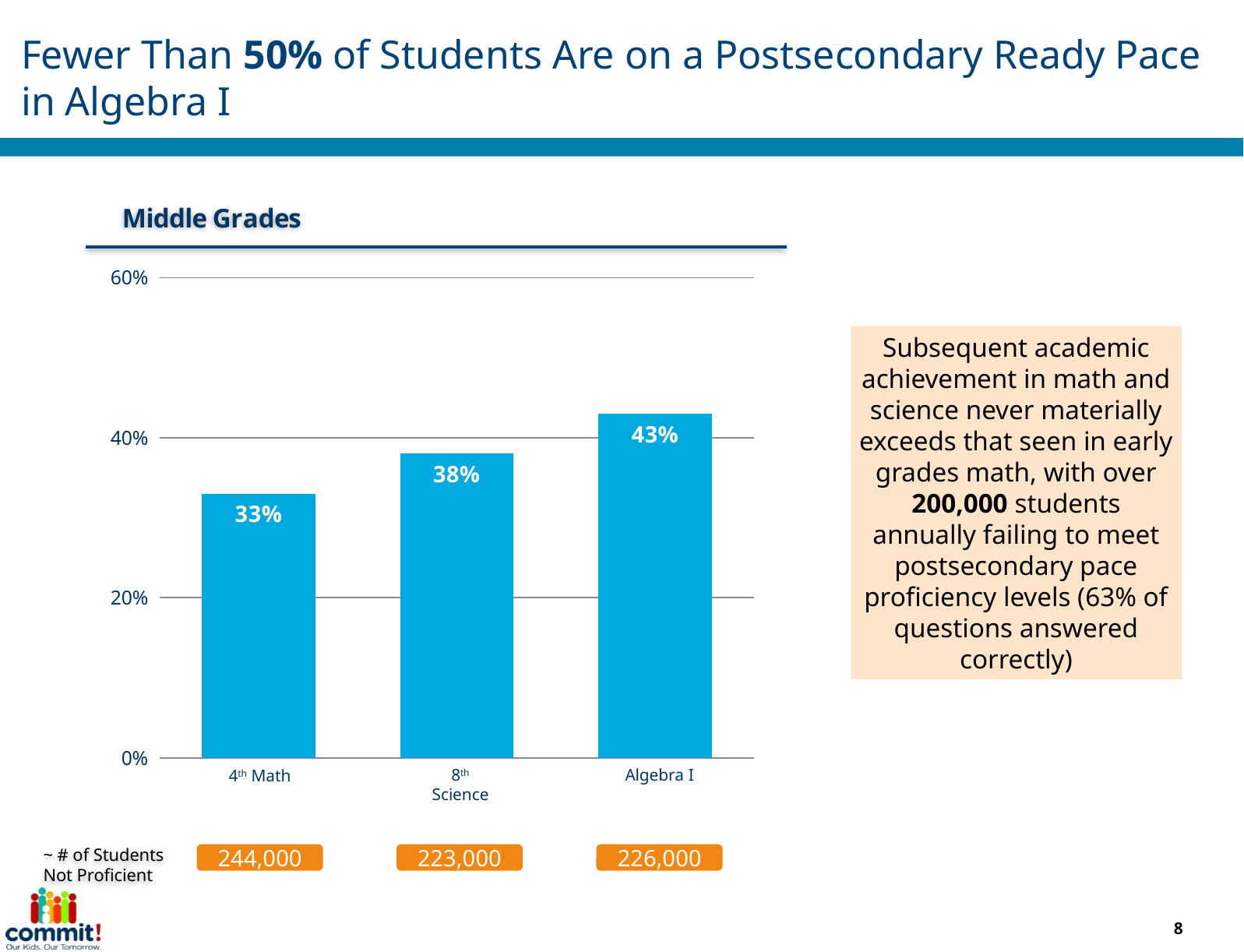
What is the value for 4th Math in the Middle Grades chart? 33% Which is larger, the value for 8th Science or the value for 4th Math? 8th Science What is the value for Algebra I in the Middle Grades chart? 43% What is the approximate number of students not proficient shown below the 8th Science bar? 223,000 What kind of chart is shown on the slide? bar chart Is the value for Algebra I greater or less than 40%? greater Do the values rise or fall from 4th Math to Algebra I along the x axis? rise Which category has the highest value in the Middle Grades chart? Algebra I What is the value for 8th Science in the Middle Grades chart? 38% Which category has the lowest value in the Middle Grades chart? 4th Math How many categories are shown in the Middle Grades chart? 3 What is the difference between the Algebra I value and the 4th Math value? 10%